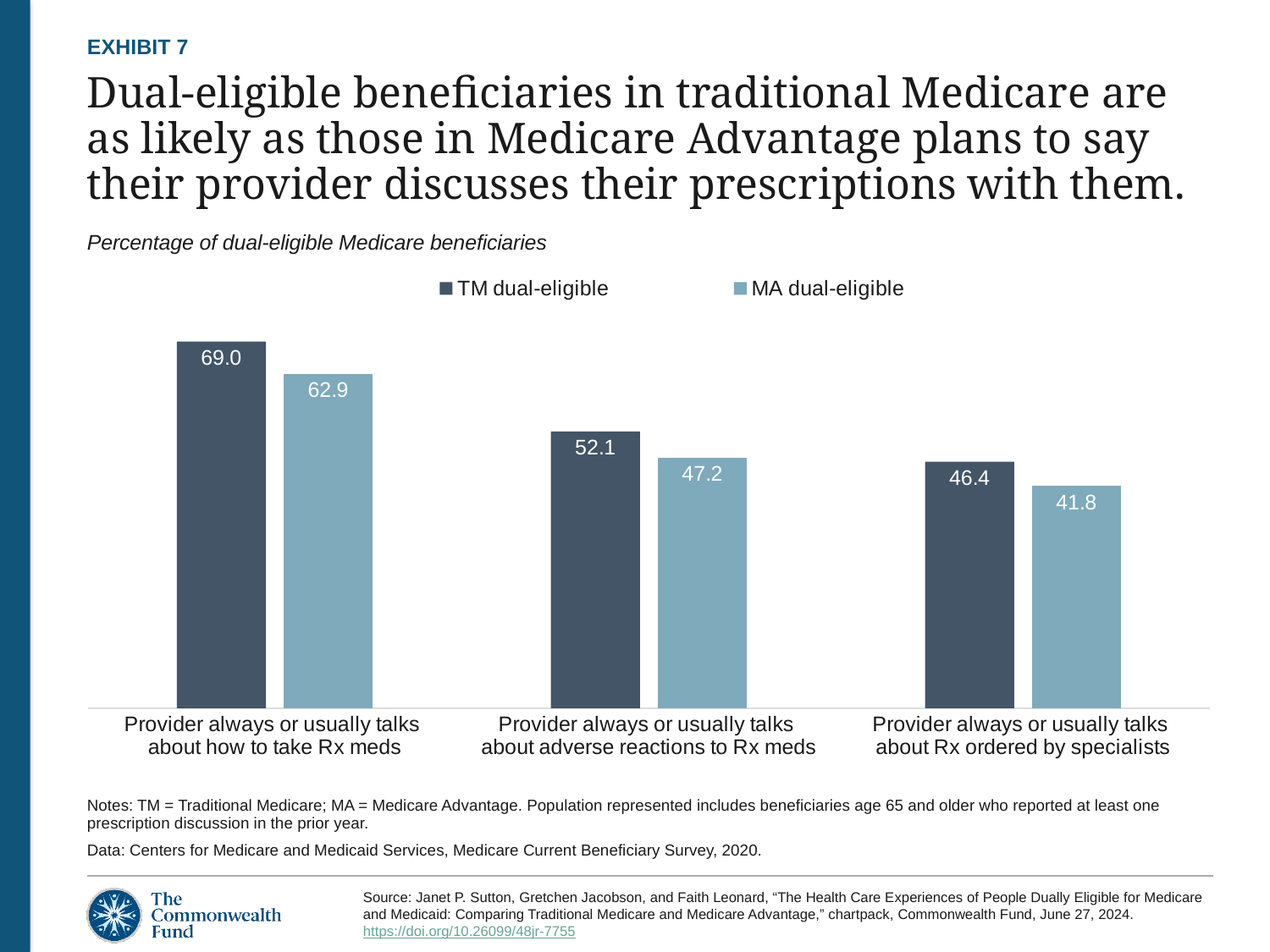
Which category has the highest MA dual-eligible value? Provider always or usually talks about how to take Rx meds What is the difference between the TM dual-eligible and MA dual-eligible values for "Provider always or usually talks about how to take Rx meds"? 6.1 What is the value for MA dual-eligible for "Provider always or usually talks about adverse reactions to Rx meds"? 47.2 What is the value for TM dual-eligible for "Provider always or usually talks about Rx ordered by specialists"? 46.4 How many categories are shown on the x axis? 3 Which category has the lowest TM dual-eligible value? Provider always or usually talks about Rx ordered by specialists For "Provider always or usually talks about adverse reactions to Rx meds", which series has the larger value, TM dual-eligible or MA dual-eligible? TM dual-eligible What is the value for TM dual-eligible for "Provider always or usually talks about how to take Rx meds"? 69.0 What is the difference between the TM dual-eligible and MA dual-eligible values for "Provider always or usually talks about Rx ordered by specialists"? 4.6 What kind of chart is shown on the slide? Bar chart How many series does the legend list? 2 Do the TM dual-eligible values rise or fall from left to right across the categories? Fall